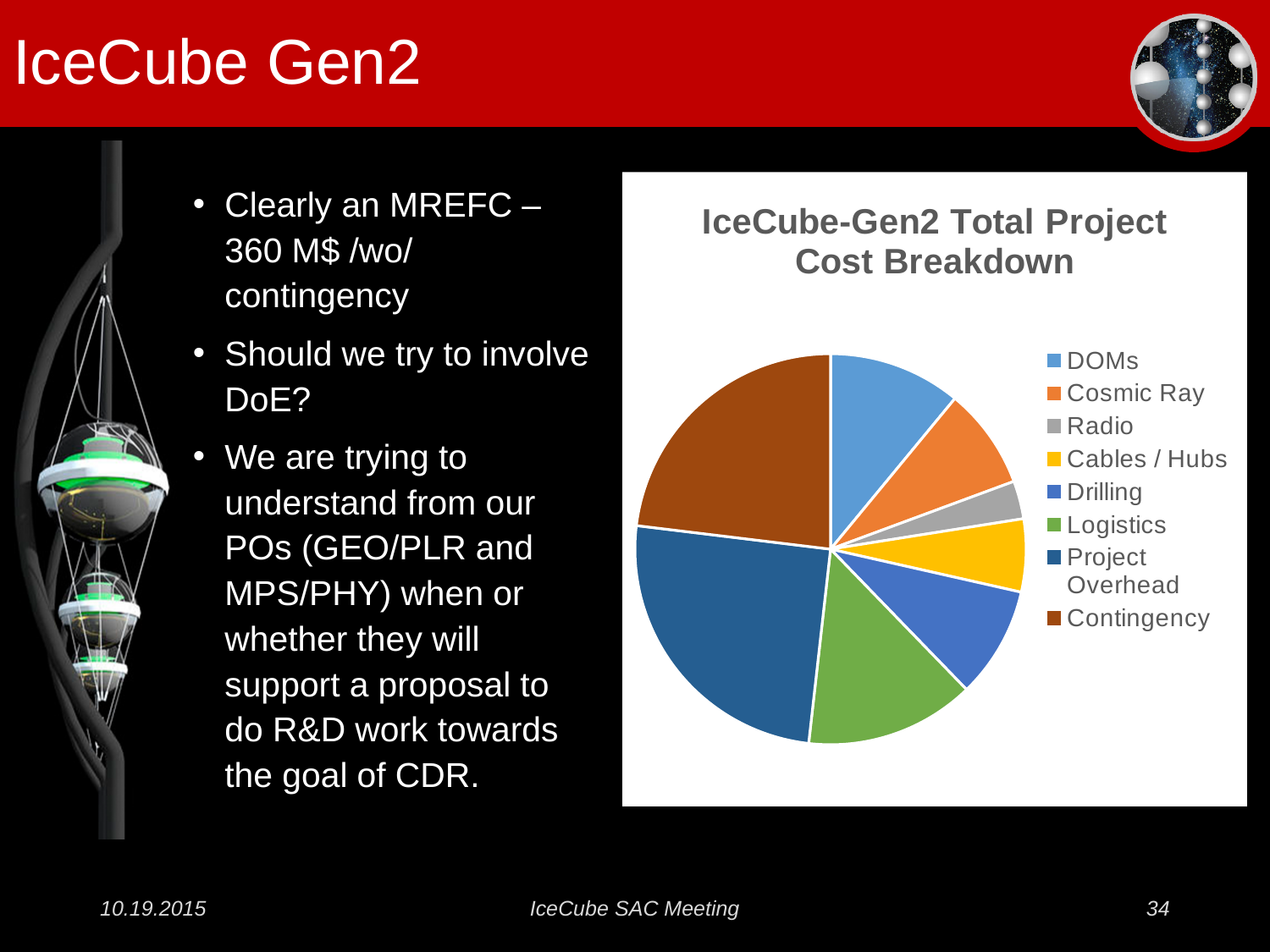
Which slice is larger, DOMs or Radio? DOMs Which category is shown in brown in the pie chart? Contingency Which slice is larger, Logistics or Cables / Hubs? Logistics What kind of chart is shown on the slide? Pie chart Which slice is larger, Project Overhead or Cables / Hubs? Project Overhead Which category has the smallest slice of the pie? Radio What is the title of the chart? IceCube-Gen2 Total Project Cost Breakdown How many categories does the pie chart show? 8